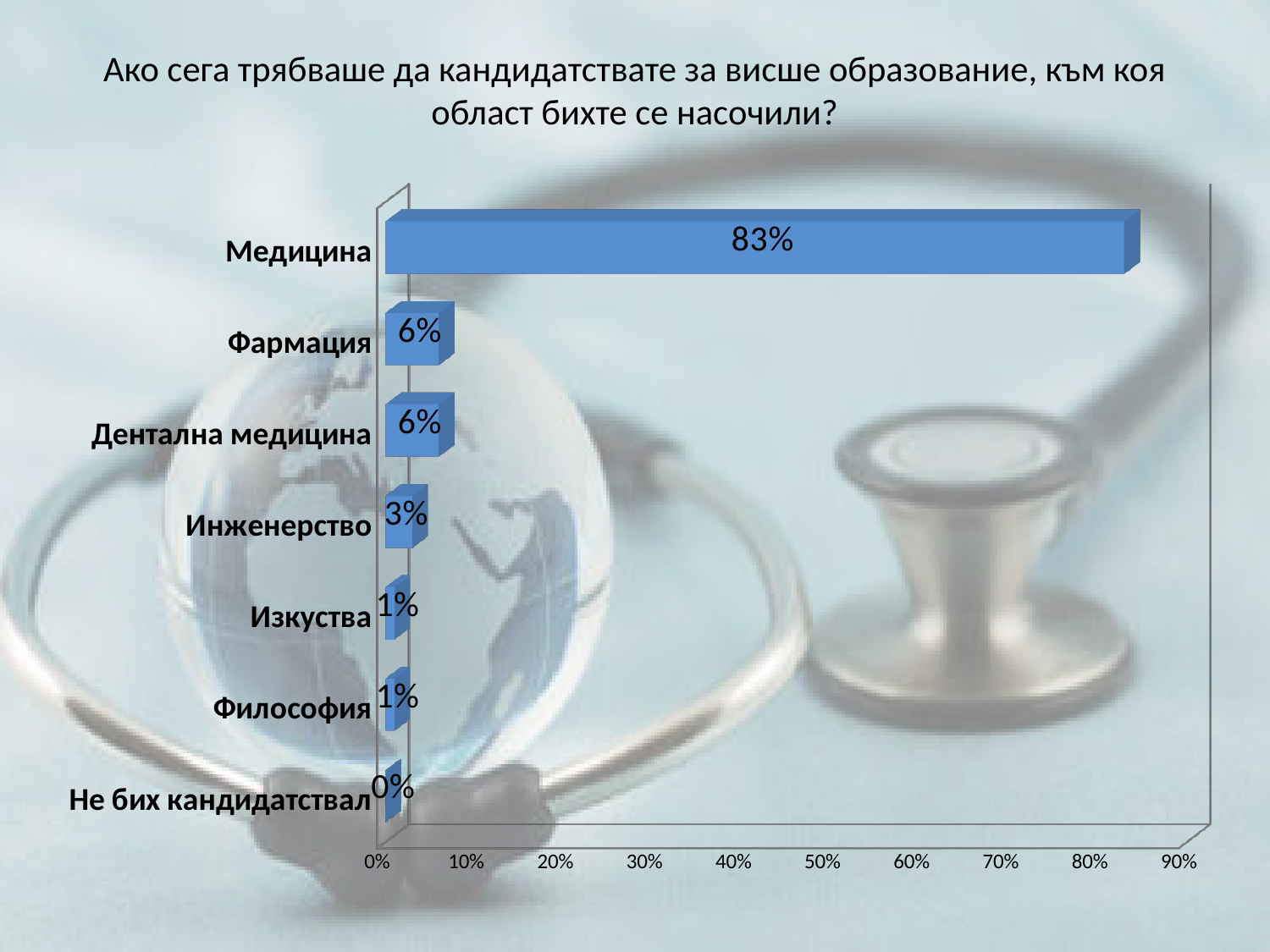
Which category has the lowest value? Не бих кандидатствал What is the value for Медицина? 83% Is the value for Медицина greater or less than 80%? greater How many categories are shown in the chart? 7 Which category has the highest value? Медицина What is the value for Инженерство? 3% What is the value for Фармация? 6% What is the difference between the values for Медицина and Фармация? 77% What is the difference between the values for Дентална медицина and Инженерство? 3% What kind of chart is shown on the slide? bar chart What is the value for Не бих кандидатствал? 0% Which is larger, the value for Инженерство or the value for Изкуства? Инженерство